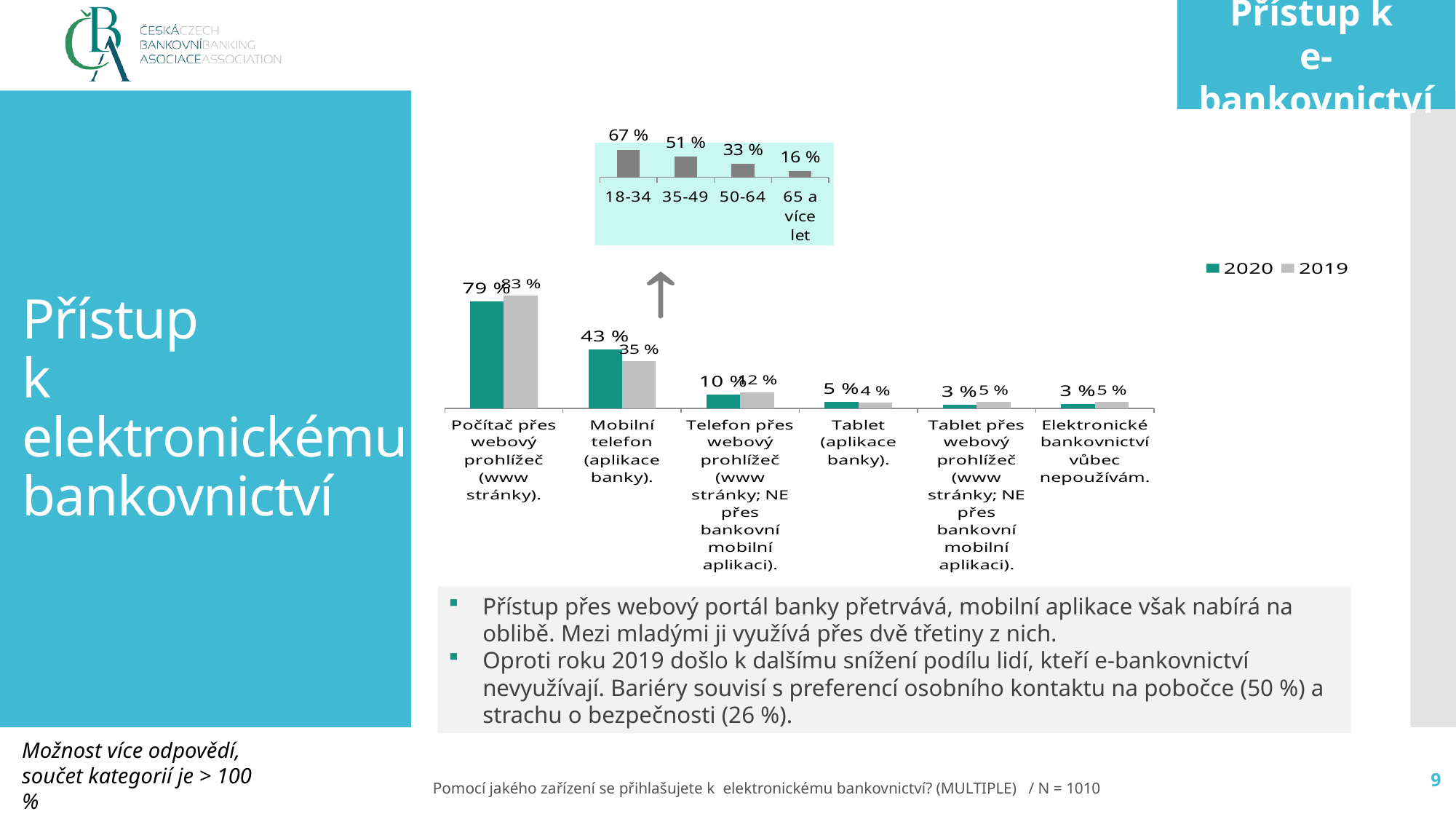
In the small inset chart above the mobile phone bar, what is the value for the 18-34 age group? 67 % In the main bar chart, what is the 2020 value for 'Mobilní telefon (aplikace banky)'? 43 % What kind of chart is the main chart on the slide? bar chart In the main bar chart, which category has the highest 2020 value? Počítač přes webový prohlížeč (www stránky) In the main bar chart, what is the 2020 value for 'Elektronické bankovnictví vůbec nepoužívám'? 3 % In the main bar chart, what is the difference between the 2020 and 2019 values for 'Mobilní telefon (aplikace banky)'? 8 % In the small inset chart above the mobile phone bar, which age group has the lowest value? 65 a více let How many categories are shown on the x axis of the main bar chart? 6 How many series does the legend of the main bar chart list? 2 In the small inset chart above the mobile phone bar, do the values rise or fall as age increases along the x axis? fall In the main bar chart, is the 2020 value for 'Počítač přes webový prohlížeč' larger or smaller than its 2019 value? smaller In the main bar chart, what is the 2019 value for 'Počítač přes webový prohlížeč (www stránky)'? 83 %